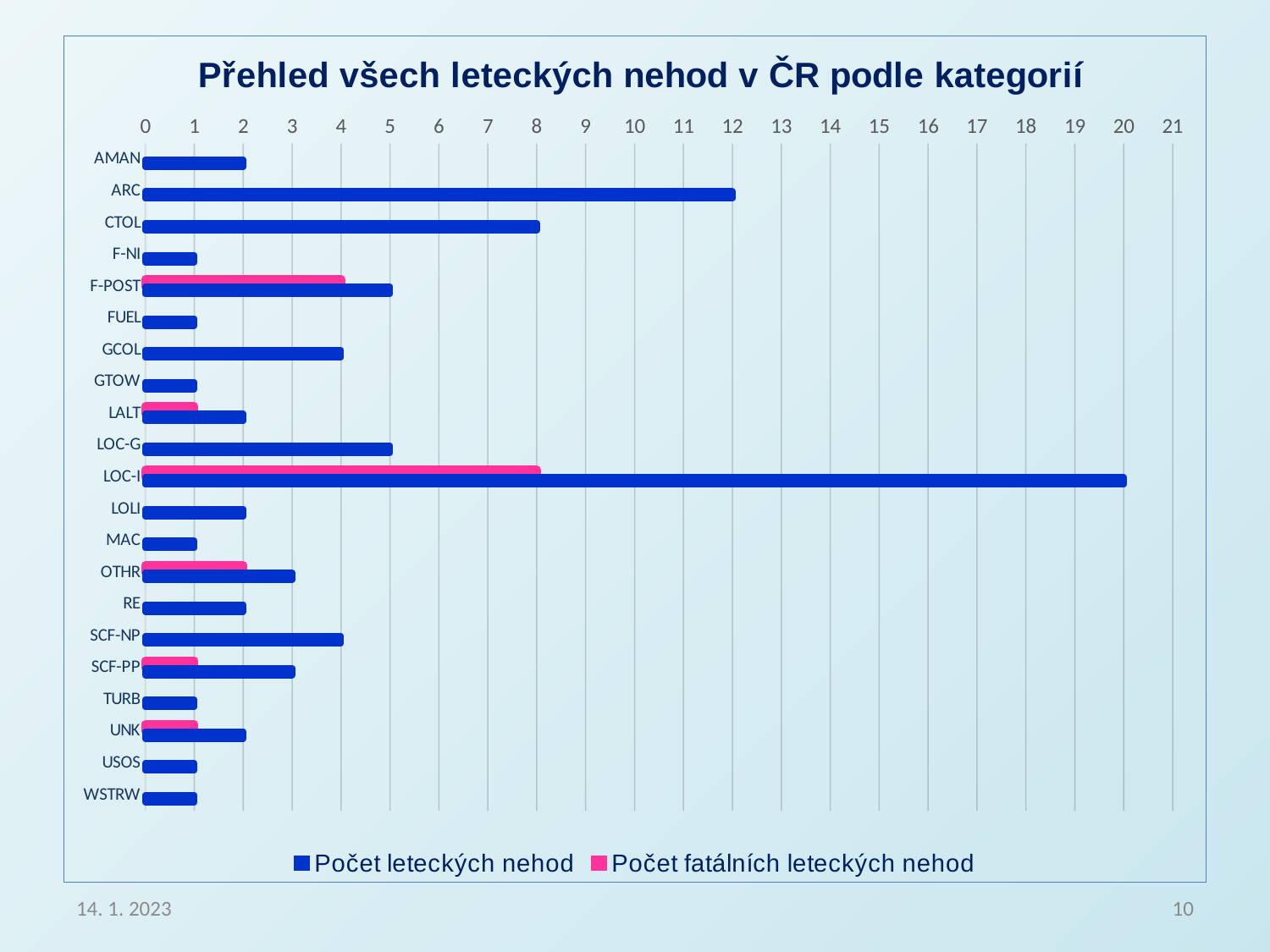
What is the difference between Počet leteckých nehod for ARC and for CTOL? 4 What is the value of Počet fatálních leteckých nehod for F-POST? 4 What is the title of the chart? Přehled všech leteckých nehod v ČR podle kategorií Which is larger: Počet leteckých nehod for GCOL or for OTHR? GCOL How many series does the legend list? 2 What is the value of Počet leteckých nehod for ARC? 12 How many categories are shown on the vertical axis? 21 What is the value of Počet fatálních leteckých nehod for LOC-I? 8 What type of chart is shown on the slide? bar chart Which category has the highest value for Počet leteckých nehod? LOC-I Is the value of Počet leteckých nehod for CTOL greater or less than 10? less What is the value of Počet leteckých nehod for LOC-I? 20